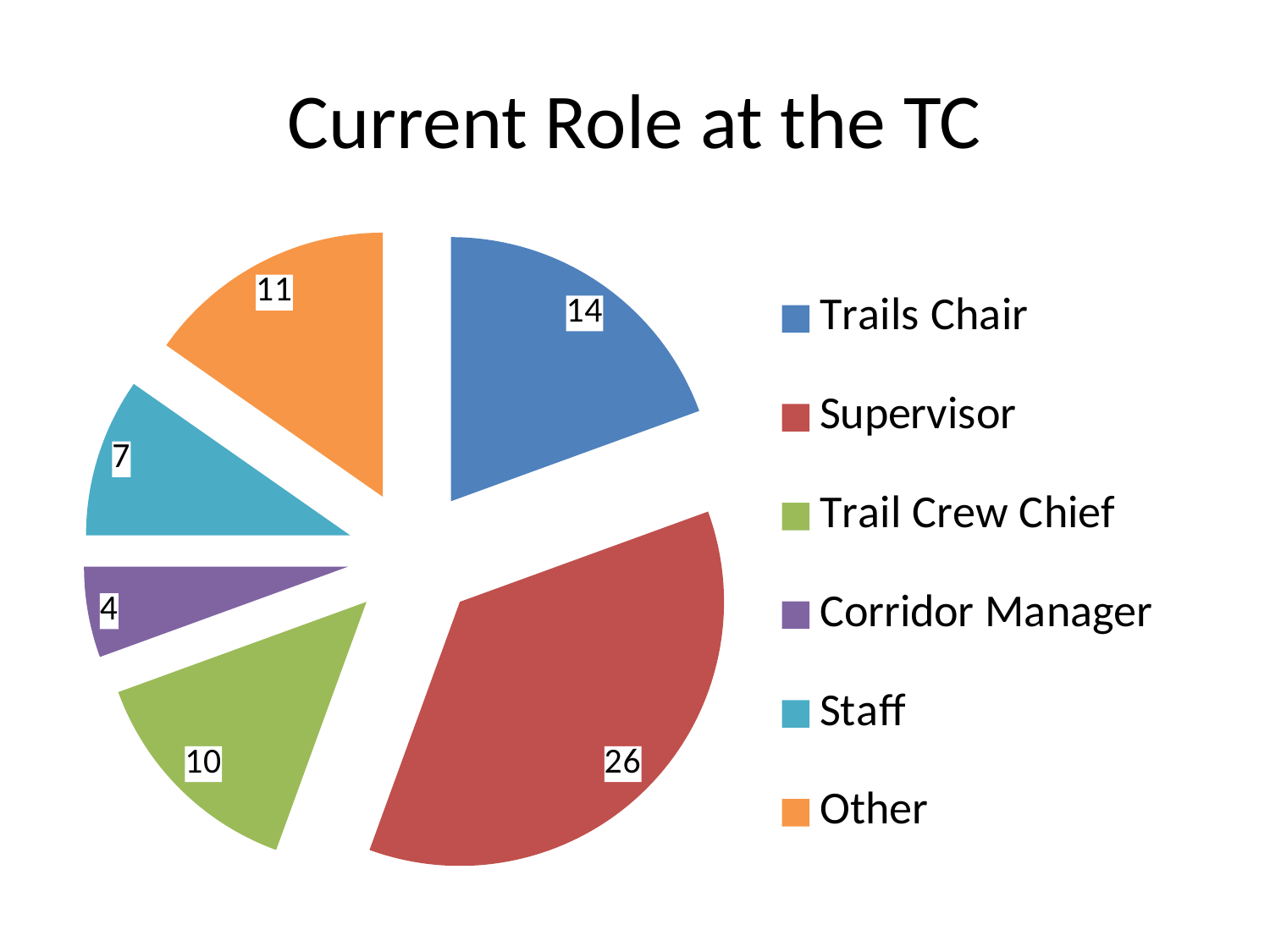
What is the value for Corridor Manager? 4 What is the title of the chart? Current Role at the TC What is the value for Other? 11 Which role has the smallest slice of the pie? Corridor Manager What is the value for Supervisor? 26 Which is larger, Trail Crew Chief or Other? Other What kind of chart is shown on the slide? Pie chart How many roles (slices) are shown in the pie chart? 6 What is the difference between the values for Supervisor and Trails Chair? 12 What is the total of all the slices in the pie chart? 72 What is the difference between the values for Other and Staff? 4 Which role has the largest slice of the pie? Supervisor